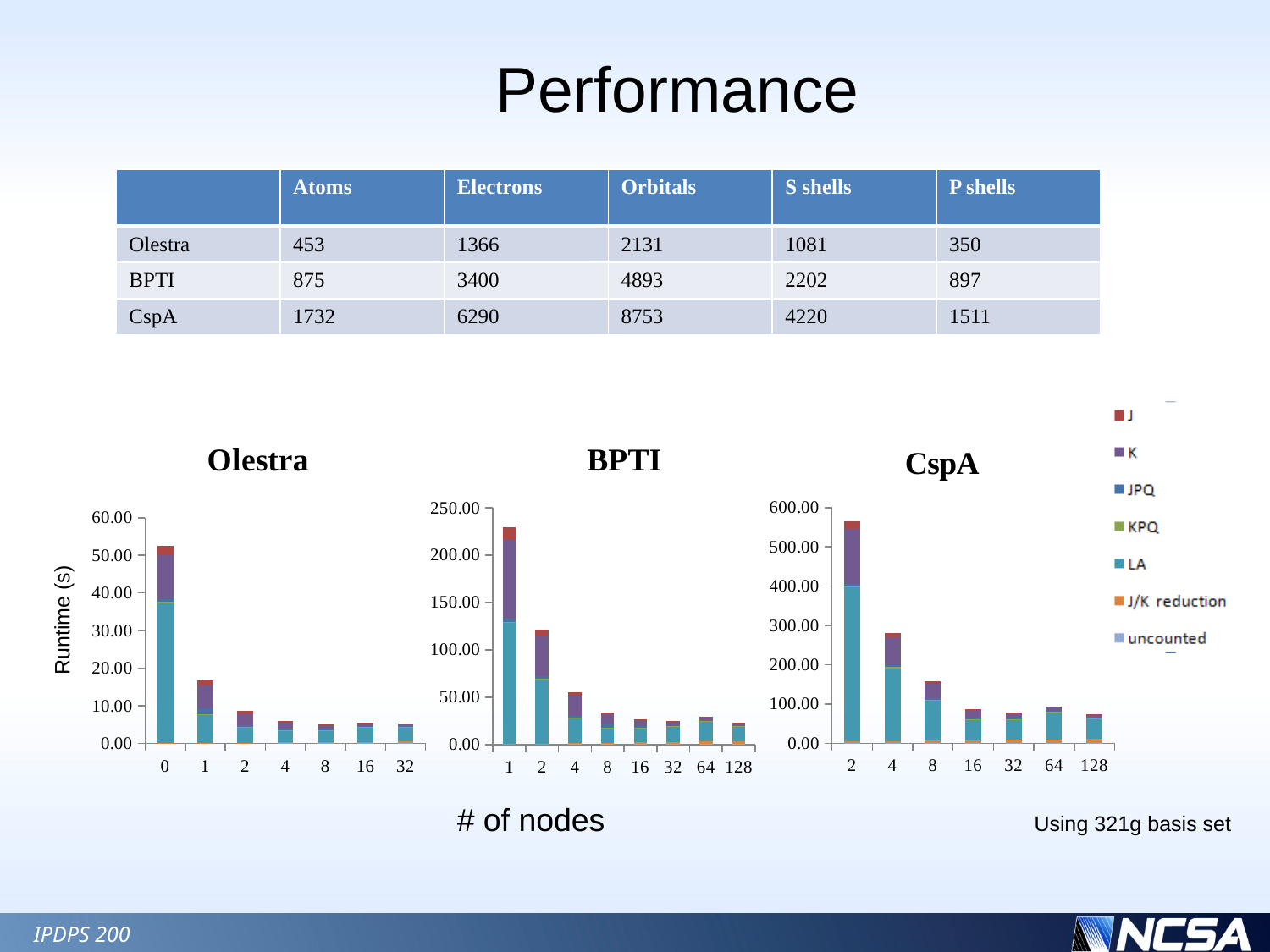
In the Olestra chart, is the total runtime for 1 node greater or less than 20.00? less In the Olestra chart, which node count has the highest total runtime? 0 In the BPTI chart, do the total runtimes rise or fall as the number of nodes increases from 1 to 8? fall In the CspA chart, which has the larger total runtime, 2 nodes or 4 nodes? 2 nodes How many series does the shared legend list for the charts? 7 In the CspA chart, is the total runtime for 2 nodes greater or less than 500.00? greater In the Olestra chart, how many node counts are shown on the x axis? 7 In the BPTI chart, is the total runtime for 1 node greater or less than 200.00? greater In the BPTI chart, which node count has the highest total runtime? 1 In the BPTI chart, how many node counts are shown on the x axis? 8 In the CspA chart, how many node counts are shown on the x axis? 7 What kind of chart is the Olestra chart? bar chart